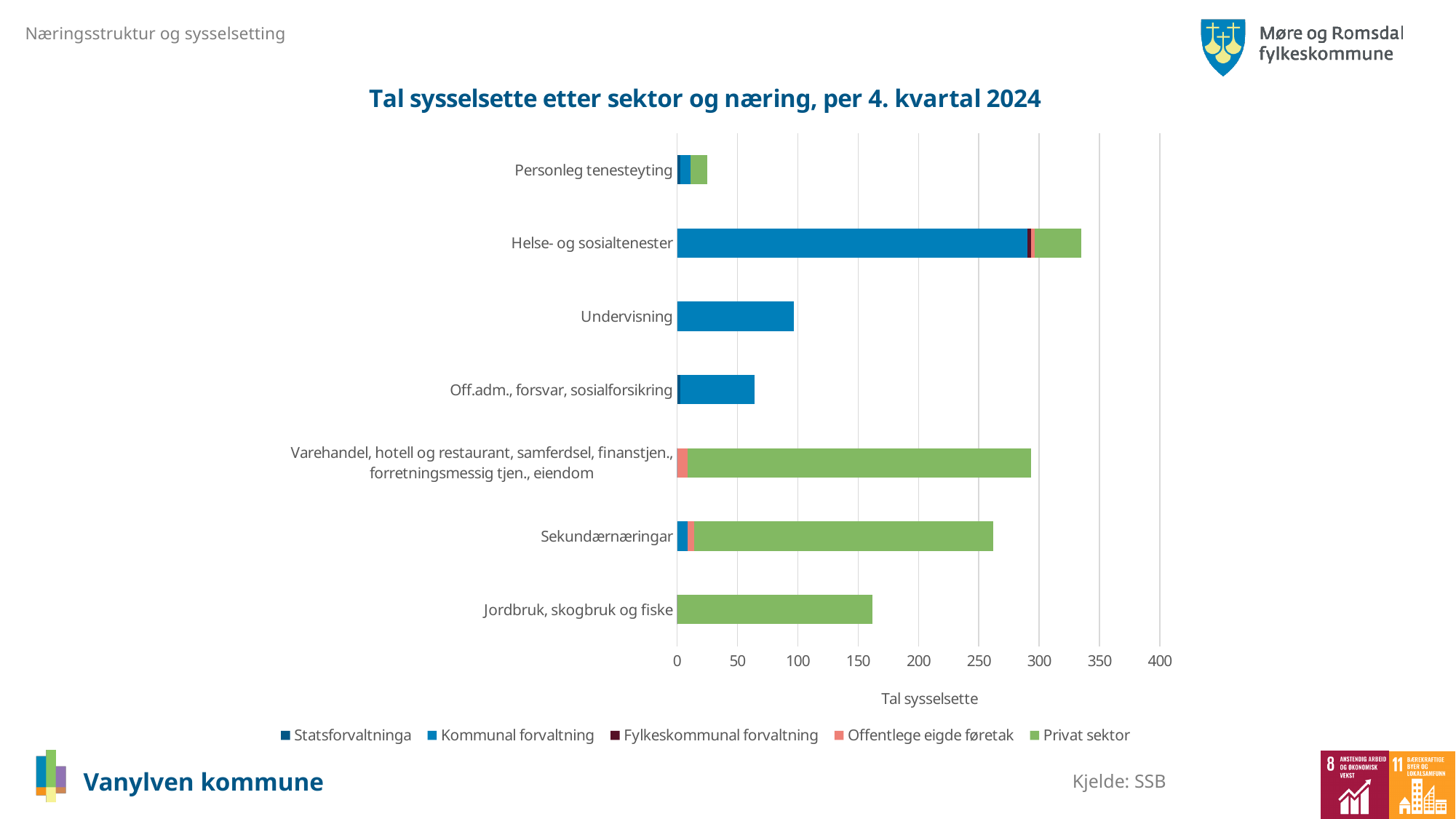
Is the total value for Sekundærnæringar greater or less than 250? greater Is the value for Jordbruk, skogbruk og fiske greater or less than 150? greater How many categories (næringar) are plotted on the y axis? 7 Which has a longer total bar, Sekundærnæringar or Jordbruk, skogbruk og fiske? Sekundærnæringar What kind of chart is shown on the slide? Stacked bar chart Which category has the shortest total bar? Personleg tenesteyting What is the title of the chart? Tal sysselsette etter sektor og næring, per 4. kvartal 2024 Is the total value for Helse- og sosialtenester greater or less than 300? greater How many series does the legend list? 5 Which has a longer bar, Undervisning or Off.adm., forsvar, sosialforsikring? Undervisning Which category has the longest total bar? Helse- og sosialtenester